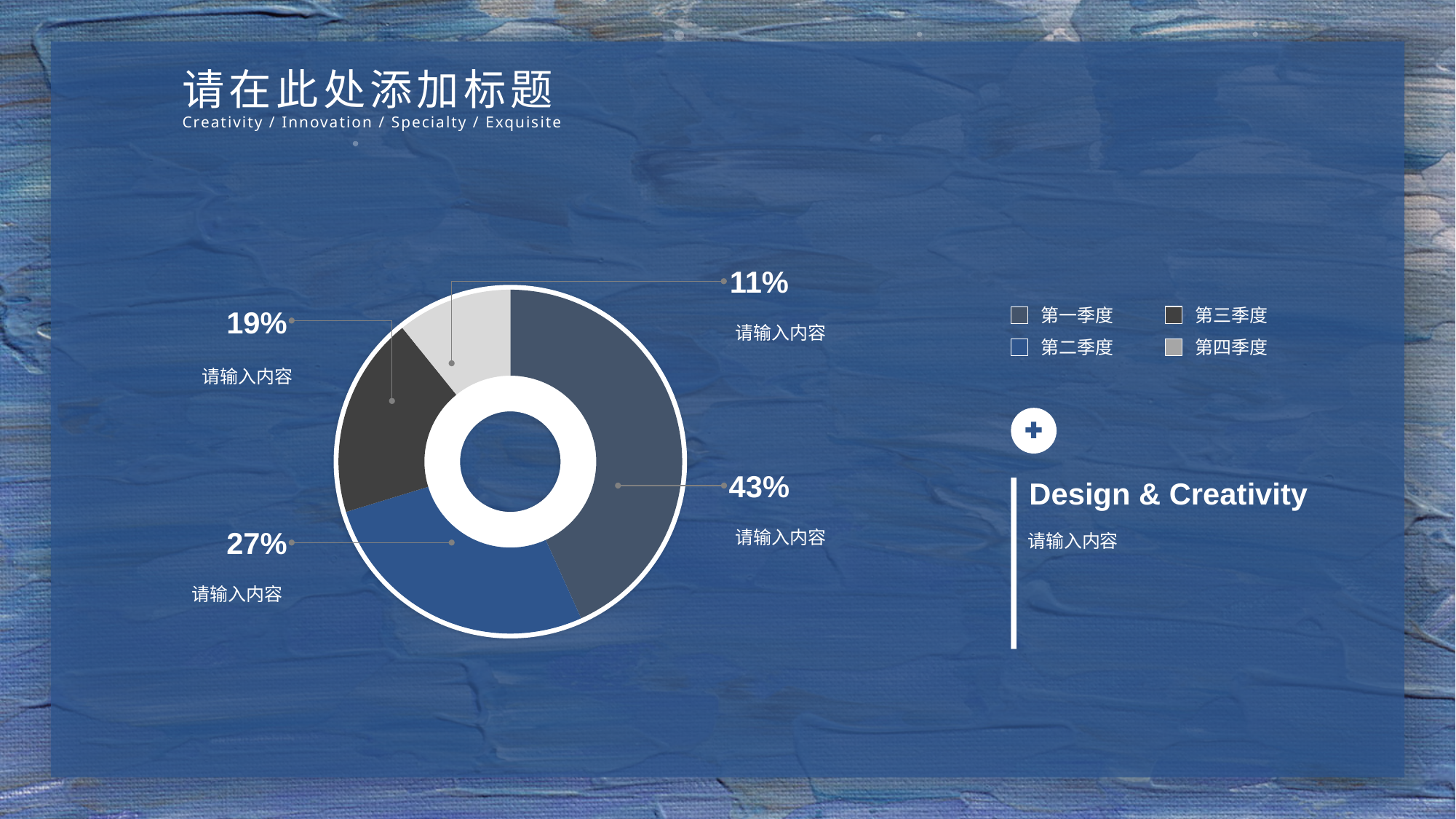
Which is larger, the dark gray slice (第三季度) or the light gray slice (第四季度)? 第三季度 (19%) What is the difference between the largest slice (43%) and the blue slice (27%)? 16 percentage points Which legend entry is shown with a dark gray marker? 第三季度 What kind of chart is shown on the slide? Pie chart (donut) What is the largest percentage shown on the pie chart? 43% How many entries does the chart legend list? 4 What percentage is shown for the dark gray slice (第三季度)? 19% What is the combined share of the 19% and 11% slices? 30% What are the four legend entries of the chart? 第一季度, 第二季度, 第三季度, 第四季度 How many slices does the pie chart have? 4 What is the smallest percentage shown on the pie chart? 11% What percentage is shown for the light gray slice (第四季度)? 11%